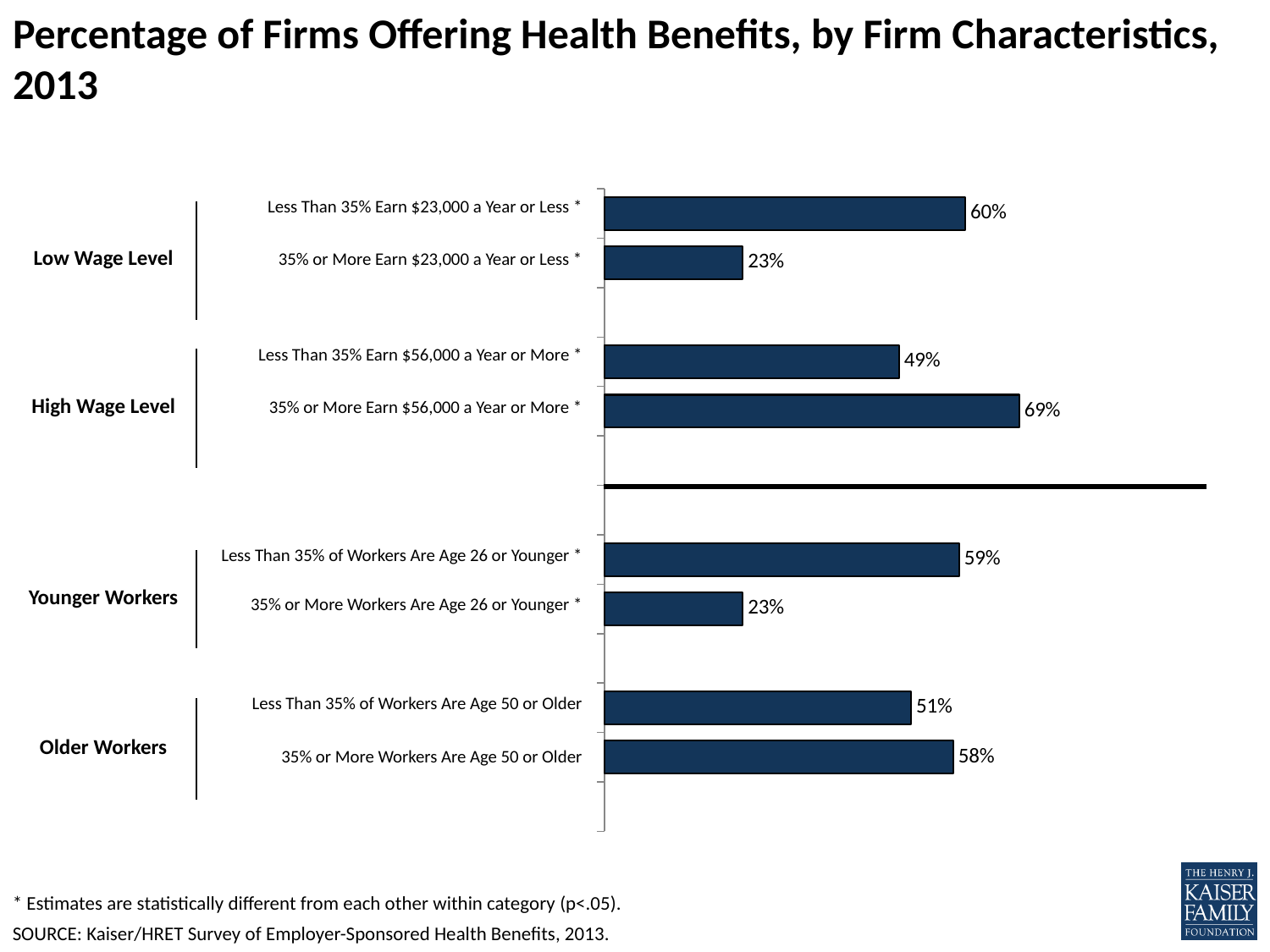
What is the difference between the two Low Wage Level bars? 37 percentage points What percentage of firms where 35% or more of workers earn $23,000 a year or less offer health benefits? 23% What is the value for firms where 35% or more of workers are age 50 or older? 58% Which category has the highest percentage of firms offering health benefits? 35% or More Earn $56,000 a Year or More What is the title of the chart? Percentage of Firms Offering Health Benefits, by Firm Characteristics, 2013 How many bars are plotted on the chart? 8 What is the difference between the two Older Workers bars? 7 percentage points What type of chart is shown on the slide? Bar chart What percentage of firms where less than 35% of workers earn $23,000 a year or less offer health benefits? 60% What is the value for firms where 35% or more of workers earn $56,000 a year or more? 69% Which is larger: the value for firms where less than 35% of workers earn $56,000 a year or more, or the value for firms where 35% or more earn $56,000 a year or more? 35% or More Earn $56,000 a Year or More What is the value for firms where less than 35% of workers are age 26 or younger? 59%